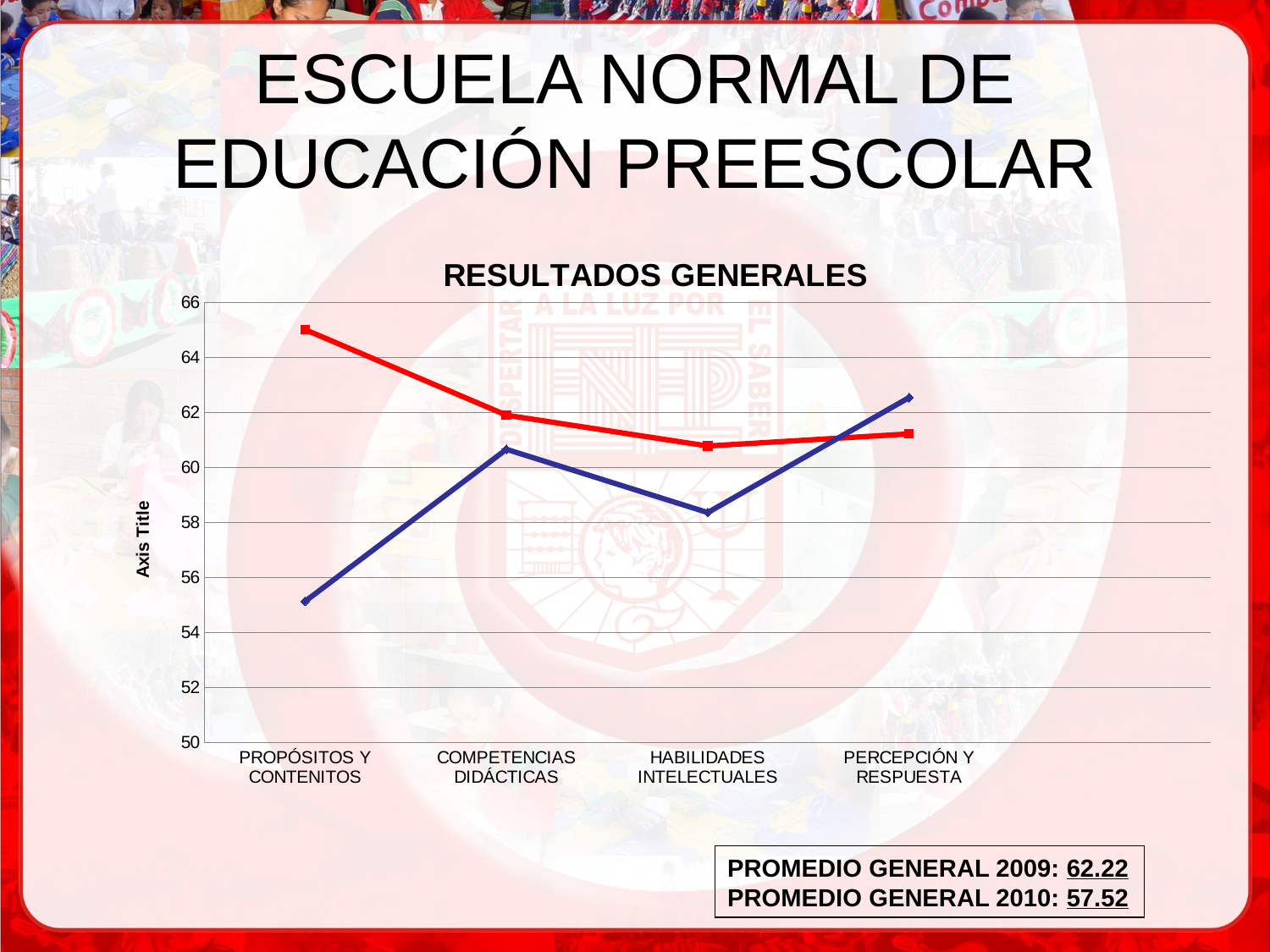
How many categories are shown on the x axis of the RESULTADOS GENERALES chart? 4 Is the value of the blue line for PROPÓSITOS Y CONTENITOS greater or less than 56? less Is the value of the red line for PROPÓSITOS Y CONTENITOS greater or less than 64? greater For which category does the blue line have its lowest value? PROPÓSITOS Y CONTENITOS For which category does the red line reach its highest value? PROPÓSITOS Y CONTENITOS What is the title of the chart? RESULTADOS GENERALES At PERCEPCIÓN Y RESPUESTA, which line has the higher value, the red line or the blue line? the blue line What kind of chart is shown under the title RESULTADOS GENERALES? line chart What text is shown as the vertical axis title of the chart? Axis Title How many lines are plotted in the RESULTADOS GENERALES chart? 2 At PROPÓSITOS Y CONTENITOS, which line has the higher value, the red line or the blue line? the red line Is the value of the blue line for HABILIDADES INTELECTUALES greater or less than 60? less